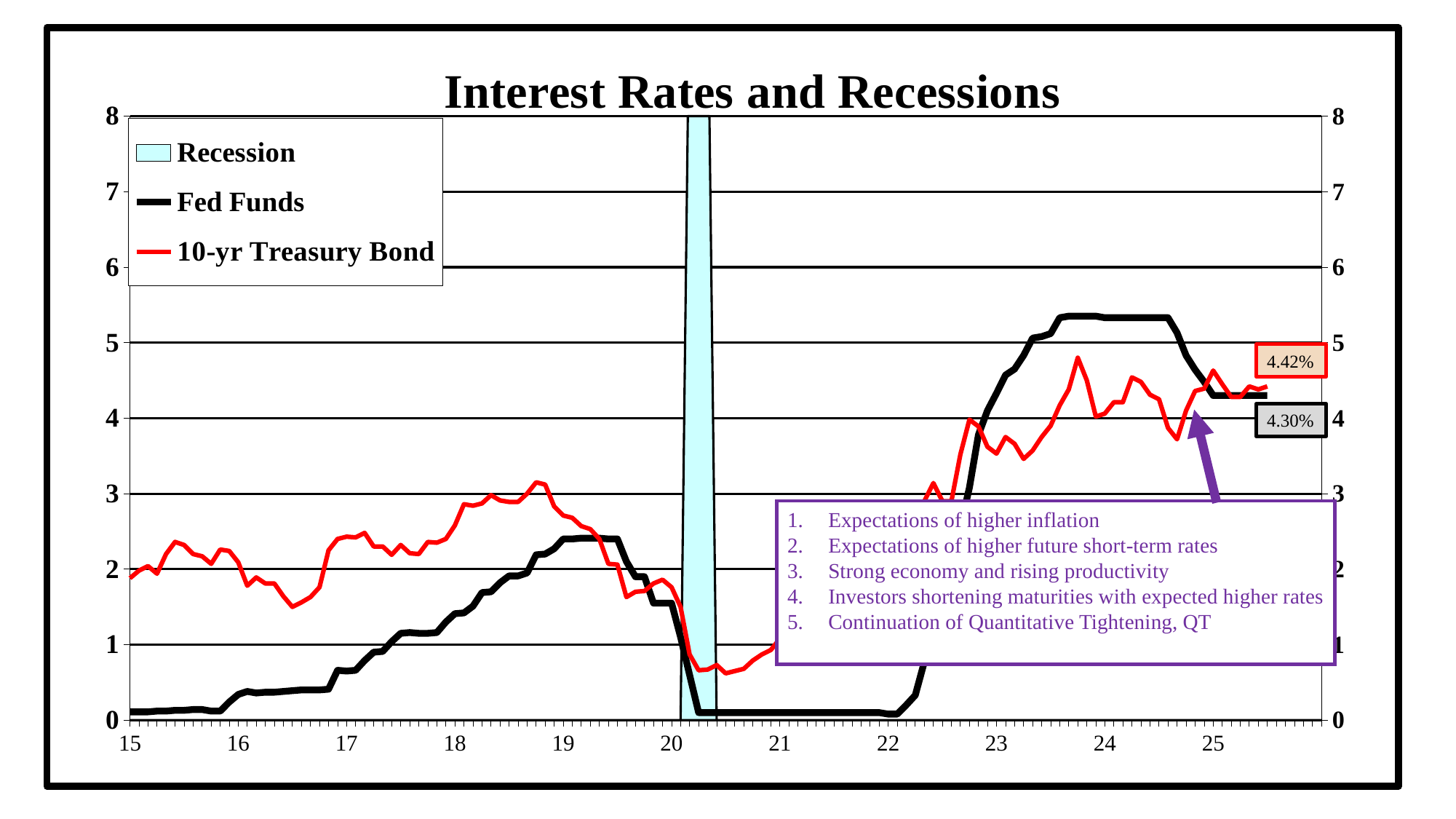
How many entries does the chart's legend list? 3 What is the labelled latest value of the 10-yr Treasury Bond series? 4.42% What is the labelled latest value of the Fed Funds series? 4.30% Is the 10-yr Treasury Bond value at the start of 2015 greater or less than 3? less At the end of the chart, which series has the higher labelled value, Fed Funds or 10-yr Treasury Bond? 10-yr Treasury Bond What is the title of the chart? Interest Rates and Recessions What colour is the Fed Funds line? black What is the difference between the labelled latest 10-yr Treasury Bond value and the labelled latest Fed Funds value? 0.12% Is the Fed Funds value during 2021 greater or less than 1? less What kind of chart is shown on the slide? line chart Does the Fed Funds series rise or fall between 2022 and 2023? rise Is the peak Fed Funds value in 2024 greater or less than 5? greater